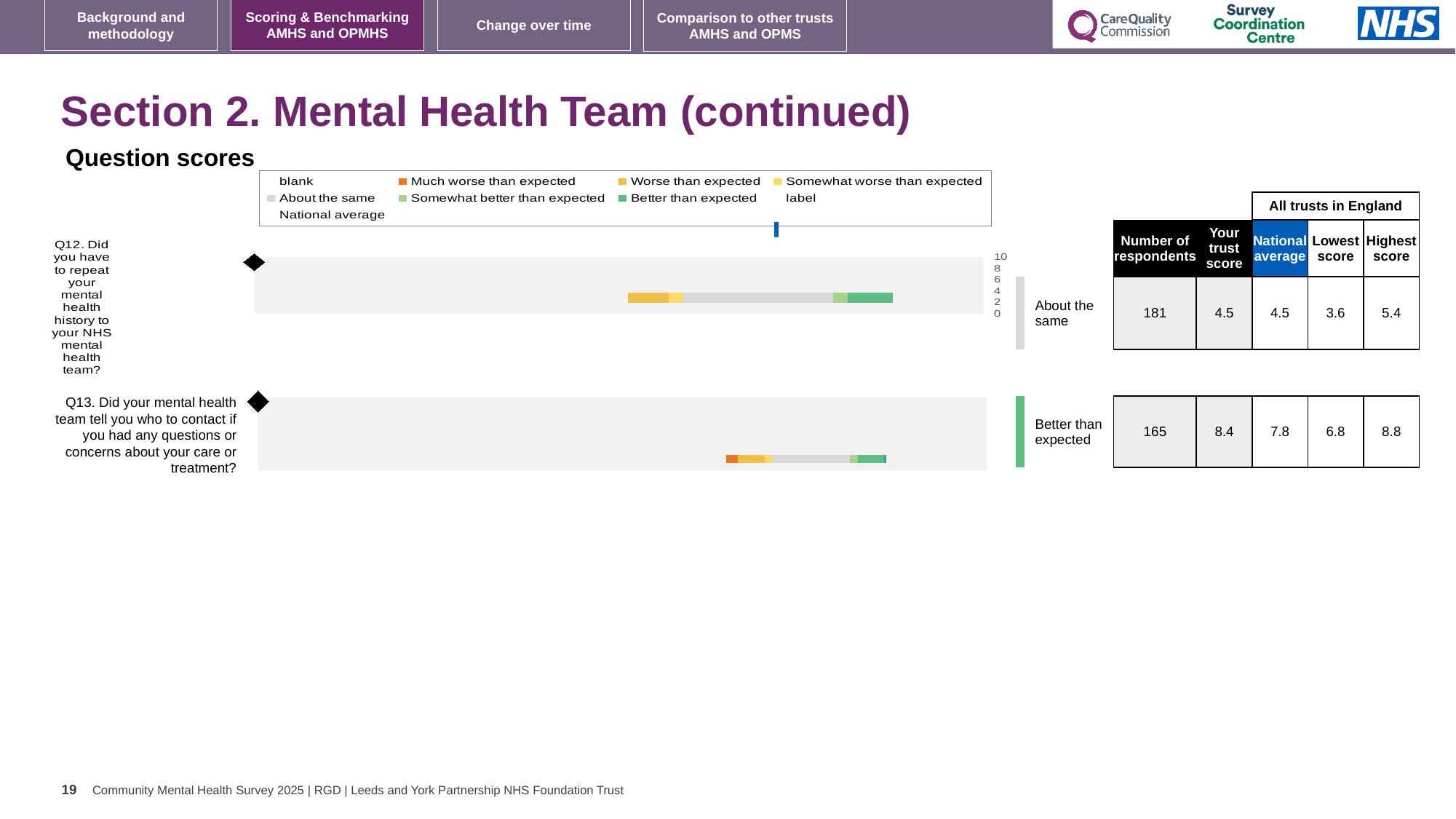
By how much does the trust score for Q13 exceed the national average for Q13? 0.6 What is the national average score for Q13? 7.8 Which question has the higher trust score, Q12 or Q13? Q13 What benchmark category is shown for Q13? Better than expected How many respondents answered Q12? 181 What is the trust score for Q12 (repeating mental health history)? 4.5 What is the trust score for Q13 (told who to contact with questions or concerns)? 8.4 Is the trust score for Q13 greater or less than 8 on the chart's axis? greater What benchmark category is shown for Q12? About the same How many questions are plotted in the question scores chart? 2 What is the difference between the highest score and the lowest score for Q12 across all trusts in England? 1.8 What kind of chart is used to show the question scores for Q12 and Q13? bar chart